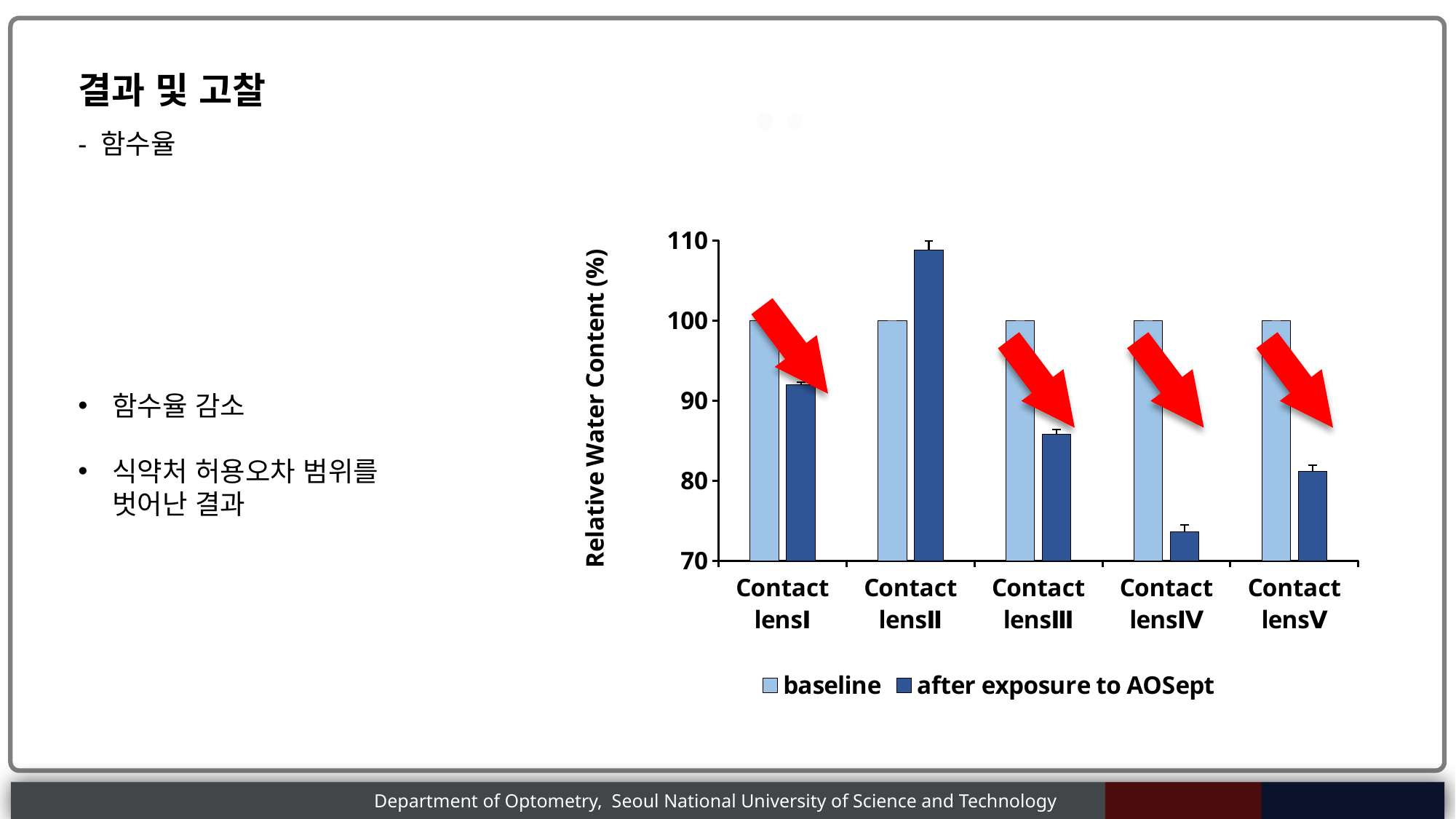
How many contact lens categories are shown on the x axis? 5 What kind of chart is shown on the slide? bar chart Is the value after exposure to AOSept for Contact lens III greater or less than 90? less What are the two series named in the legend? baseline; after exposure to AOSept What is the baseline value for Contact lens III? 100 Is the value after exposure to AOSept for Contact lens IV greater or less than 80? less How many series does the legend list? 2 Which contact lens has the highest value after exposure to AOSept? Contact lensII What is the label of the y axis? Relative Water Content (%) Which contact lens has the lowest value after exposure to AOSept? Contact lensIV Which is larger: the value after exposure to AOSept for Contact lens I or for Contact lens V? Contact lensI Is the value after exposure to AOSept for Contact lens II greater or less than 100? greater